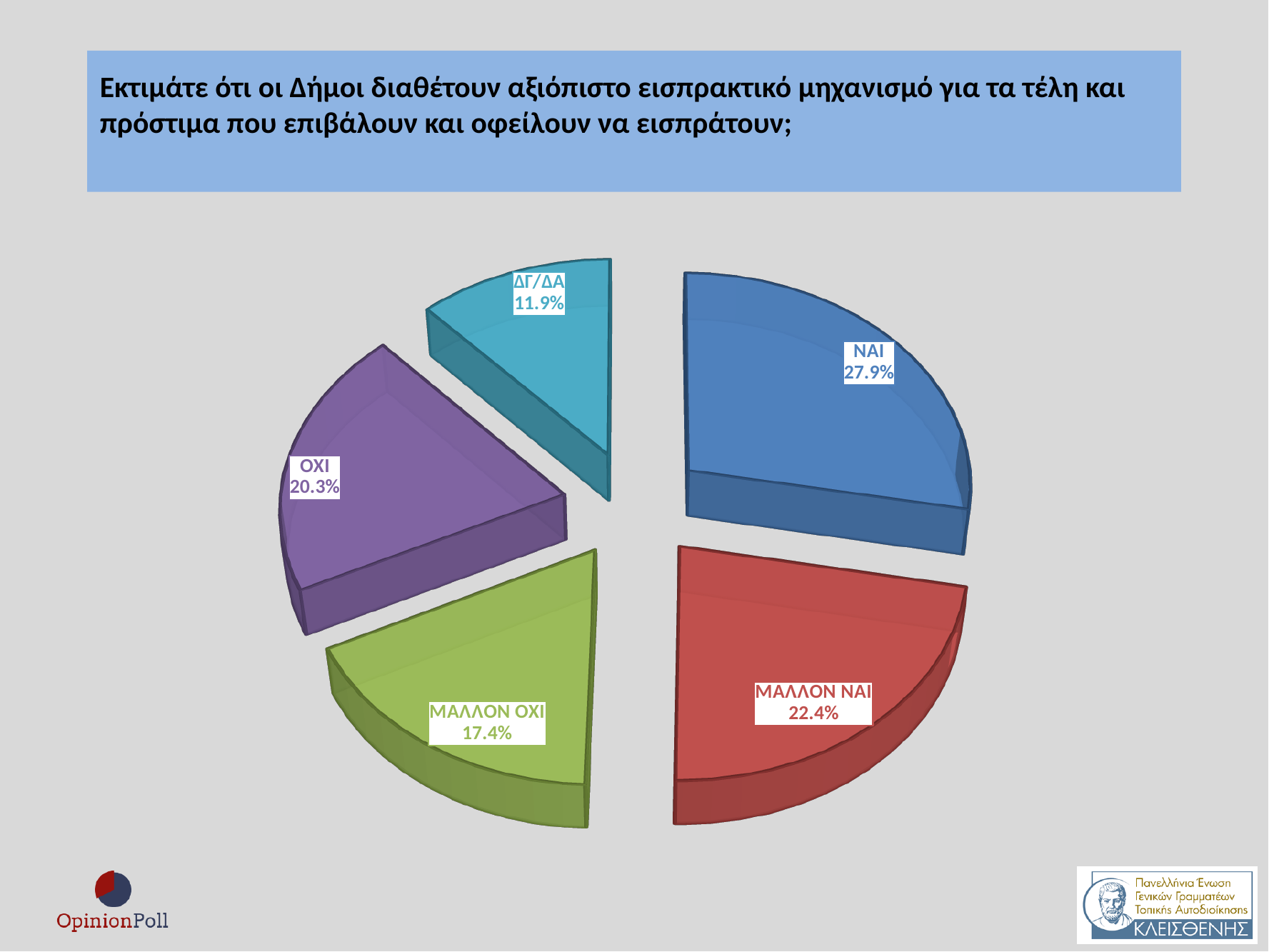
What percentage is shown for ΟΧΙ? 20.3% Which is larger, ΟΧΙ or ΜΑΛΛΟΝ ΟΧΙ? ΟΧΙ What kind of chart is shown on the slide? Pie chart What is the combined percentage of ΝΑΙ and ΜΑΛΛΟΝ ΝΑΙ? 50.3% What percentage is shown for ΔΓ/ΔΑ? 11.9% Which category has the largest share of the pie? ΝΑΙ What percentage is shown for ΝΑΙ? 27.9% What colour is the ΜΑΛΛΟΝ ΝΑΙ slice? Red How many slices does the pie chart have? 5 What is the difference in percentage points between ΝΑΙ and ΜΑΛΛΟΝ ΝΑΙ? 5.5 Which category has the smallest share of the pie? ΔΓ/ΔΑ What percentage is shown for ΜΑΛΛΟΝ ΟΧΙ? 17.4%